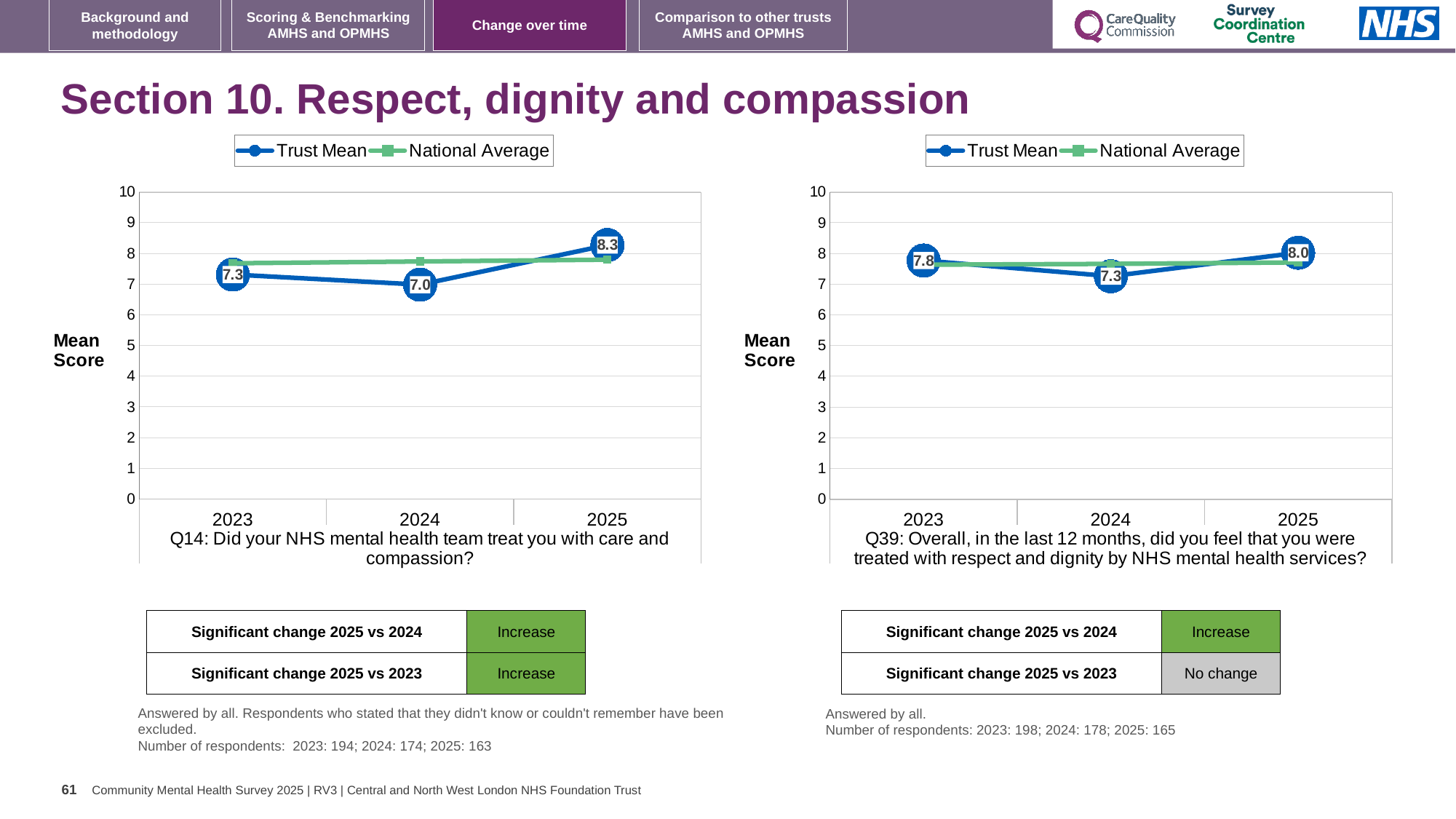
In the Q39 chart on the right, what is the Trust Mean for 2025? 8.0 In the Q14 chart on the left, what is the difference between the Trust Mean for 2025 and the Trust Mean for 2024? 1.3 What kind of chart is the Q14 chart on the left? Line chart How many series does the legend of the Q39 chart on the right list? 2 In the Q39 chart on the right, which year has the lowest Trust Mean? 2024 In the Q14 chart on the left, which year has the highest Trust Mean? 2025 In the Q14 chart on the left, is the National Average for 2024 greater or less than 7? greater In the Q39 chart on the right, what is the Trust Mean for 2023? 7.8 Which is larger: the 2025 Trust Mean in the Q14 chart on the left or the 2025 Trust Mean in the Q39 chart on the right? Q14 chart (8.3) In the Q14 chart on the left, what is the Trust Mean for 2025? 8.3 In the Q14 chart on the left, what is the Trust Mean for 2024? 7.0 In the Q39 chart on the right, what is the difference between the Trust Mean for 2023 and the Trust Mean for 2024? 0.5